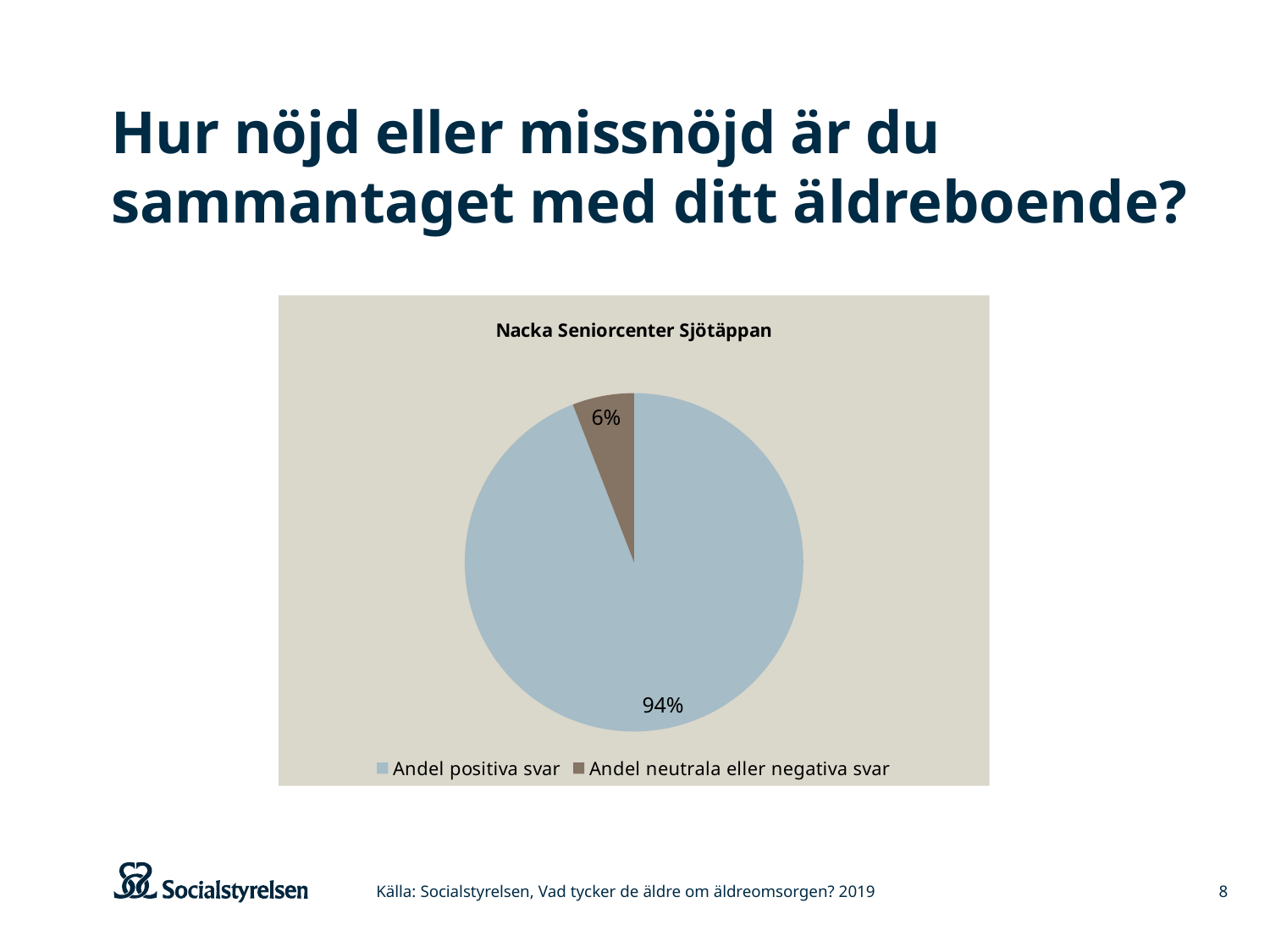
How many slices does the pie chart have? 2 What is the chart's title? Nacka Seniorcenter Sjötäppan Which slice is the smallest? Andel neutrala eller negativa svar What share of the pie does Andel neutrala eller negativa svar represent? 6% What is the value for Andel neutrala eller negativa svar? 6% What colour is the Andel positiva svar slice? light blue Which is larger, Andel positiva svar or Andel neutrala eller negativa svar? Andel positiva svar What is the value for Andel positiva svar? 94% How many entries does the legend list? 2 Which slice is the largest? Andel positiva svar What kind of chart is shown on the slide? pie chart What is the difference between Andel positiva svar and Andel neutrala eller negativa svar? 88%